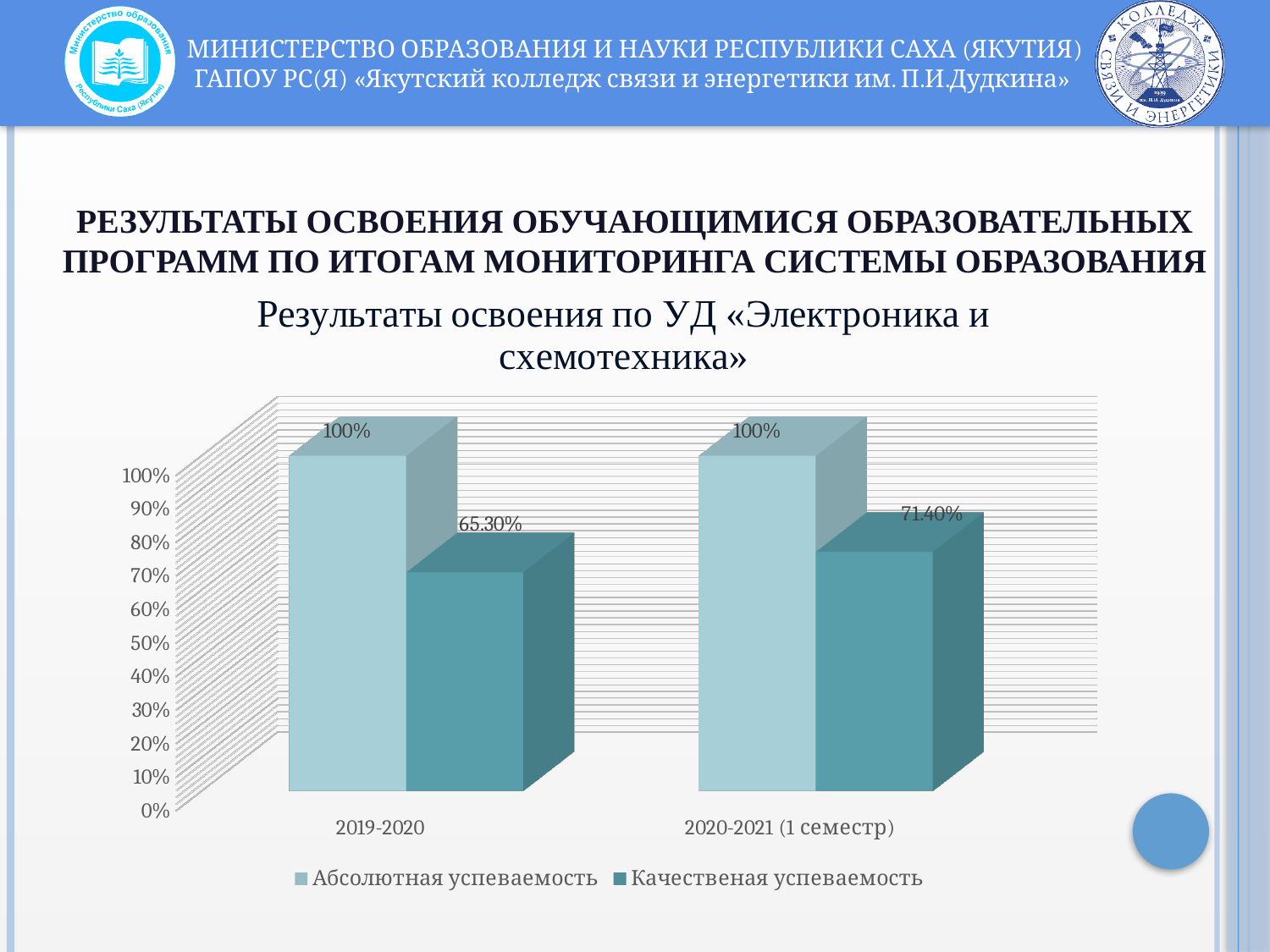
What is the value of Качественая успеваемость for 2020-2021 (1 семестр)? 71.40% What is the value of Абсолютная успеваемость for 2020-2021 (1 семестр)? 100% Is Качественая успеваемость for 2019-2020 greater or less than 70%? less Does Качественая успеваемость rise or fall from 2019-2020 to 2020-2021 (1 семестр)? rise Which period has the higher Качественая успеваемость? 2020-2021 (1 семестр) What is the difference in Качественая успеваемость between 2020-2021 (1 семестр) and 2019-2020? 6.10% How many series does the legend list? 2 What is the value of Качественая успеваемость for 2019-2020? 65.30% What is the value of Абсолютная успеваемость for 2019-2020? 100% How many periods (categories) are shown on the x axis? 2 Which period has the lower Качественая успеваемость? 2019-2020 What kind of chart is shown on the slide? bar chart